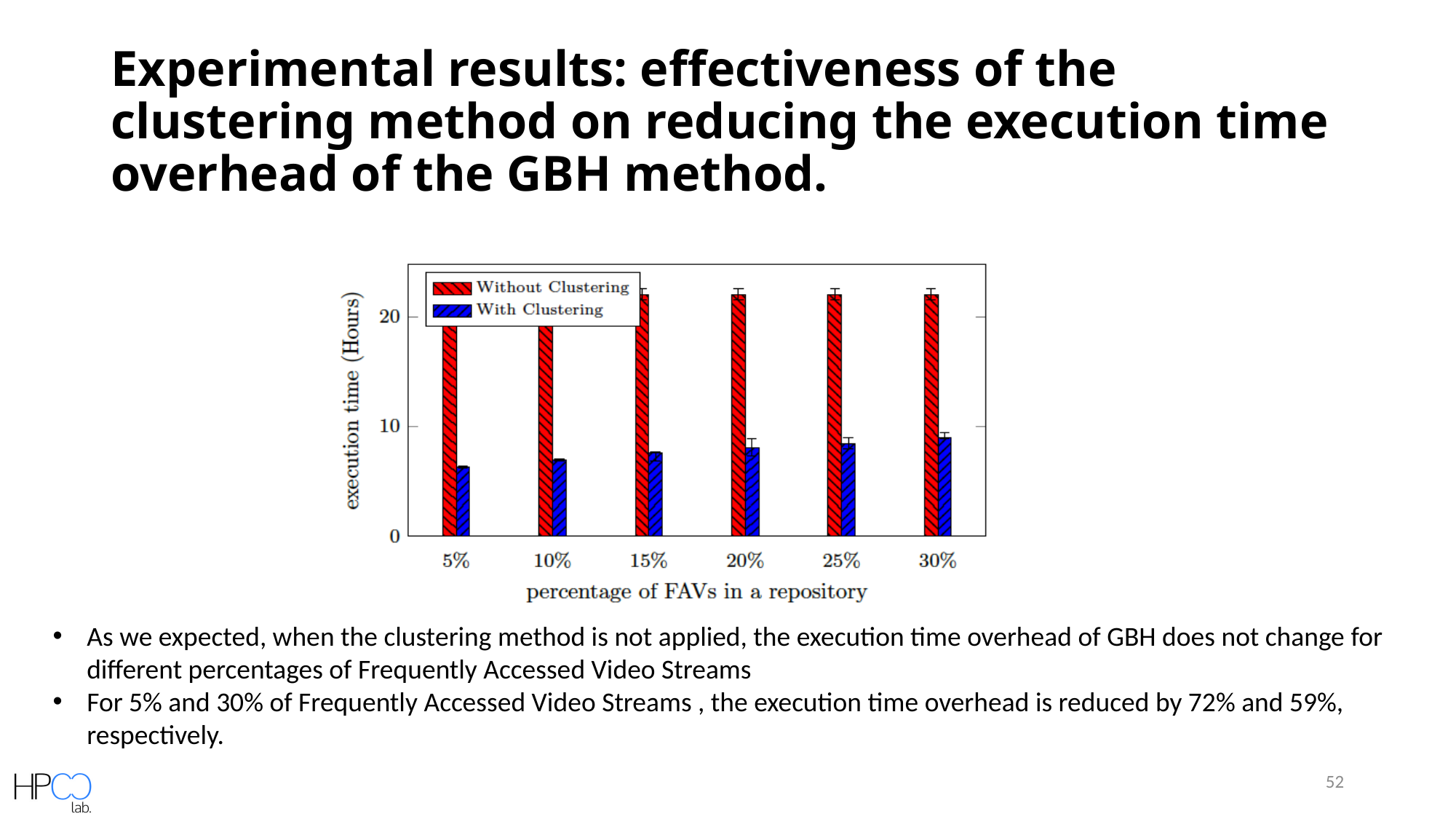
Which two series are listed in the legend? Without Clustering and With Clustering At 15%, which series has the larger execution time, Without Clustering or With Clustering? Without Clustering For the With Clustering series, which is larger, the value at 5% or the value at 30%? 30% Is the With Clustering value at 5% greater or less than 10? less How many percentage categories are shown on the x axis? 6 Is the With Clustering value at 30% greater or less than 10? less How many series does the legend list? 2 What kind of chart is shown on the slide? bar chart Do the With Clustering values rise or fall as the percentage of FAVs increases from 5% to 30%? rise What is the label of the y axis? execution time (Hours) Is the Without Clustering value at 20% greater or less than 20? greater